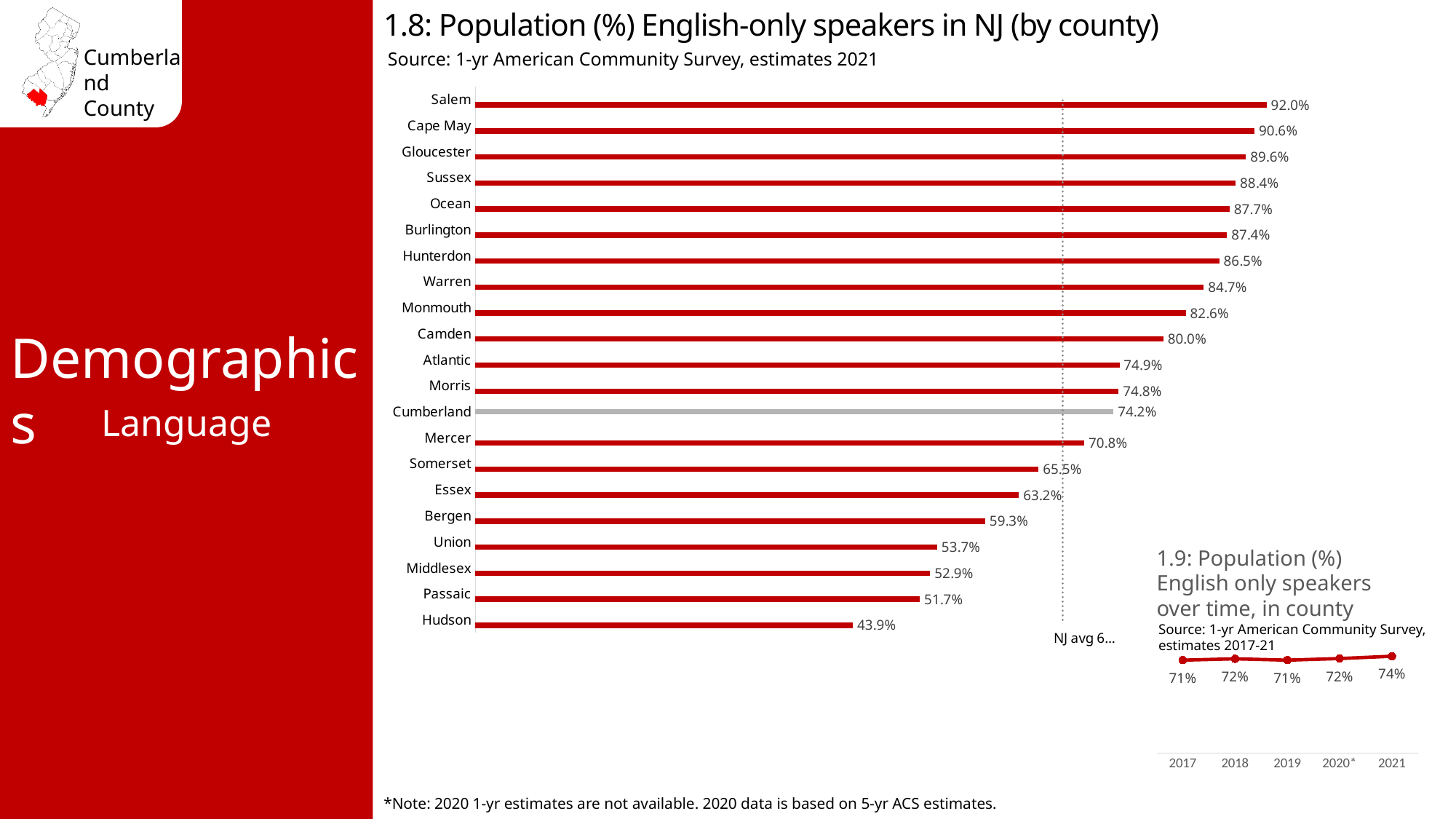
In chart 1.8, which county has the highest percentage of English-only speakers? Salem In chart 1.8, what is the difference between the values for Salem and Hudson? 48.1% In chart 1.8, what is the value for Hudson? 43.9% In chart 1.8, which county has the lowest percentage of English-only speakers? Hudson In chart 1.8, which bar is coloured grey instead of red? Cumberland In chart 1.8, how many counties are shown? 21 In chart 1.8, what is the value for Bergen? 59.3% In chart 1.8, what is the value for Cumberland? 74.2% In chart 1.9, how many years are plotted? 5 In chart 1.9, what is the value for 2021? 74% In chart 1.8, which is larger, the value for Camden or the value for Mercer? Camden What kind of chart is chart 1.8? Bar chart